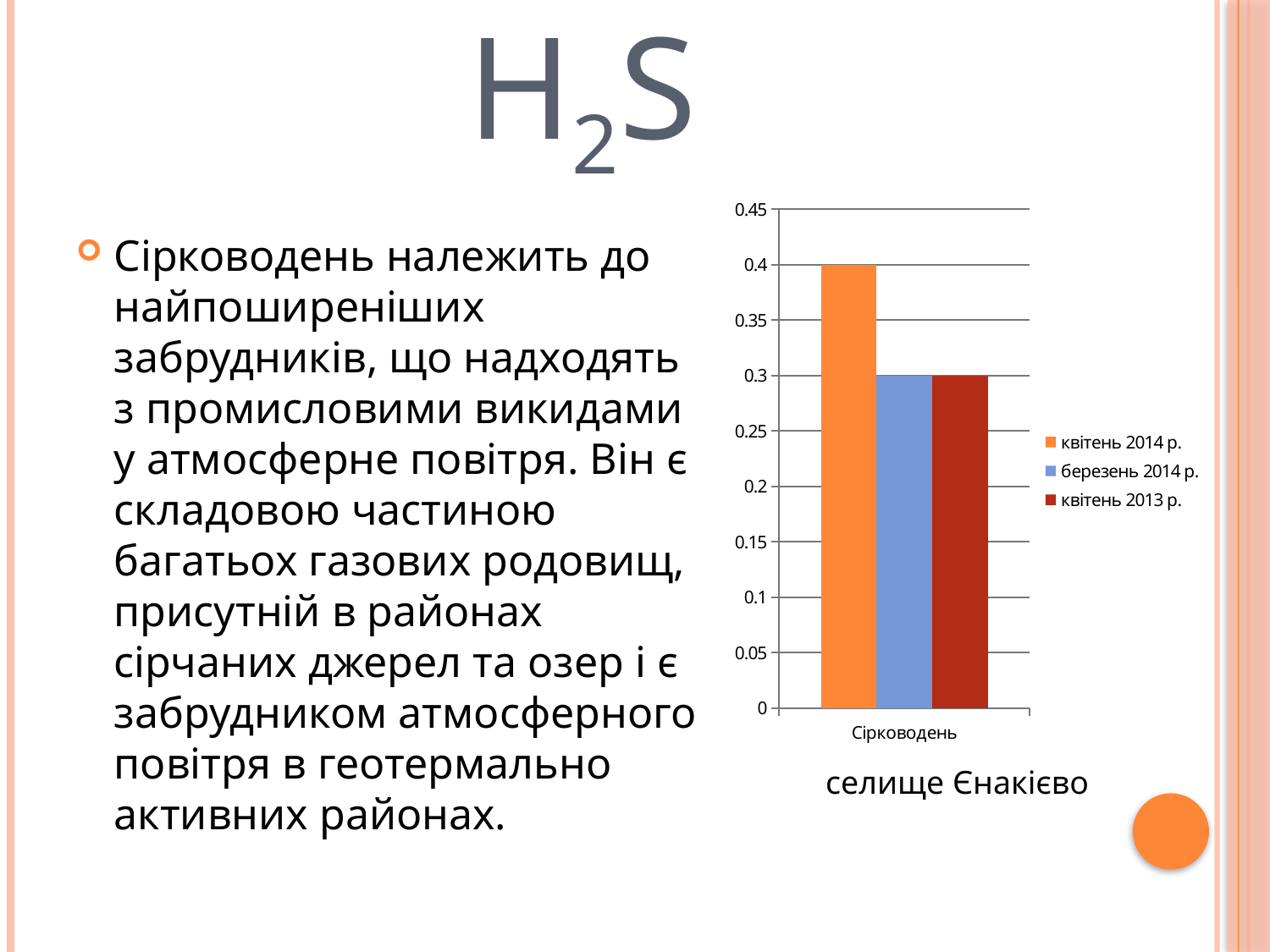
How many categories are shown on the x axis of the chart? 1 What is the value for квітень 2013 р. in the chart? 0.3 Which series has the highest value in the chart? квітень 2014 р. Is the value for квітень 2014 р. greater or less than 0.35? greater What is the value for березень 2014 р. in the chart? 0.3 Which series is shown in orange in the chart? квітень 2014 р. What kind of chart is shown on the slide? bar chart Which is larger, the value for квітень 2014 р. or the value for березень 2014 р.? квітень 2014 р. What is the value for квітень 2014 р. in the chart? 0.4 How many series does the chart legend list? 3 What is the difference between the value for квітень 2014 р. and the value for квітень 2013 р.? 0.1 What is the category label shown on the x axis of the chart? Сірководень